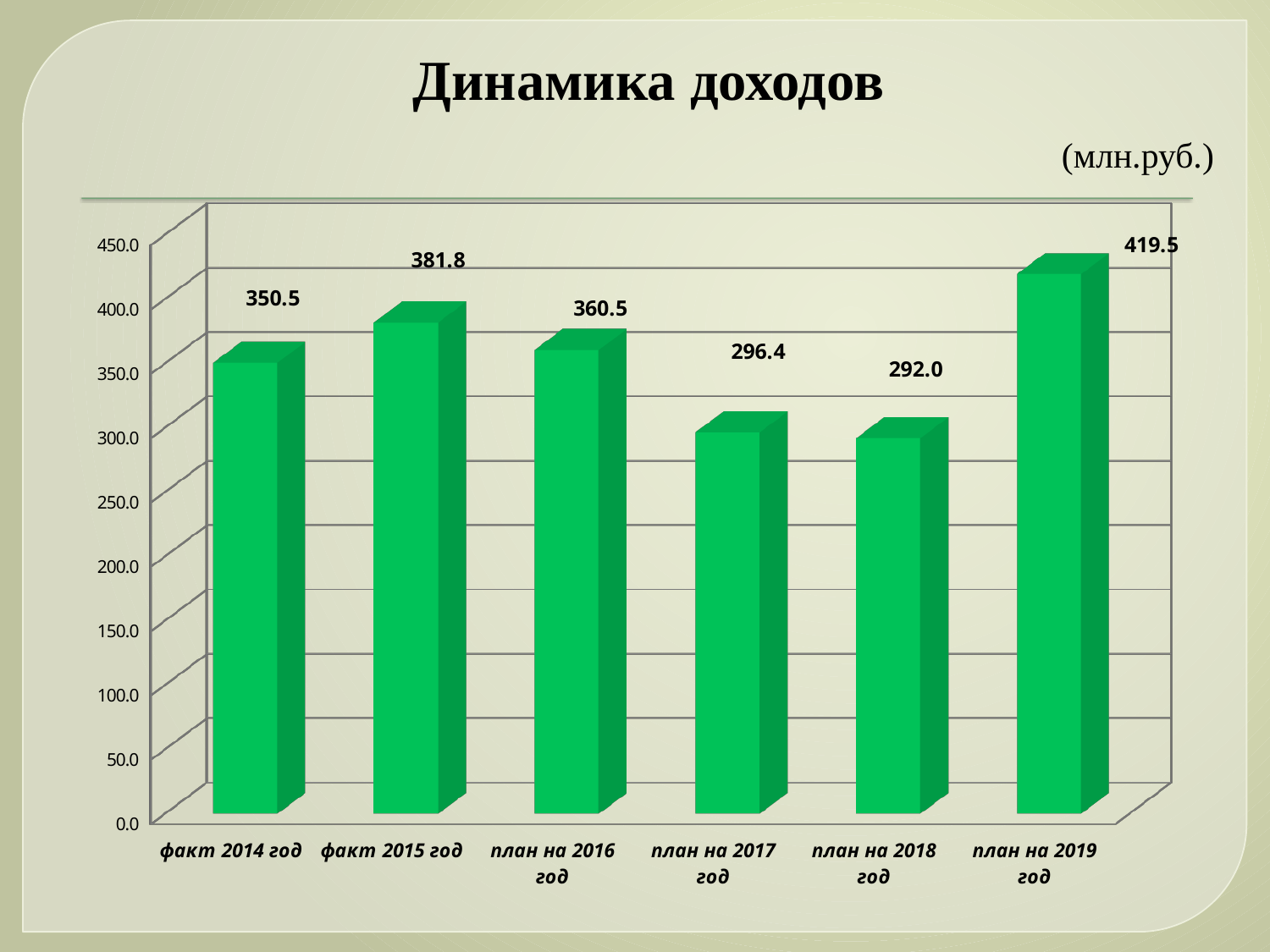
What is the value for план на 2019 год? 419.5 What is the value for план на 2017 год? 296.4 What kind of chart is shown on the slide? bar chart What is the difference between the values for план на 2019 год and план на 2018 год? 127.5 Which is larger, the value for факт 2015 год or the value for план на 2016 год? факт 2015 год What is the value for факт 2014 год? 350.5 Which category has the lowest value? план на 2018 год Is the value for план на 2017 год greater or less than 300.0? less How many categories are shown on the chart? 6 Which category has the highest value? план на 2019 год What is the difference between the values for факт 2015 год and факт 2014 год? 31.3 What is the title of the chart? Динамика доходов